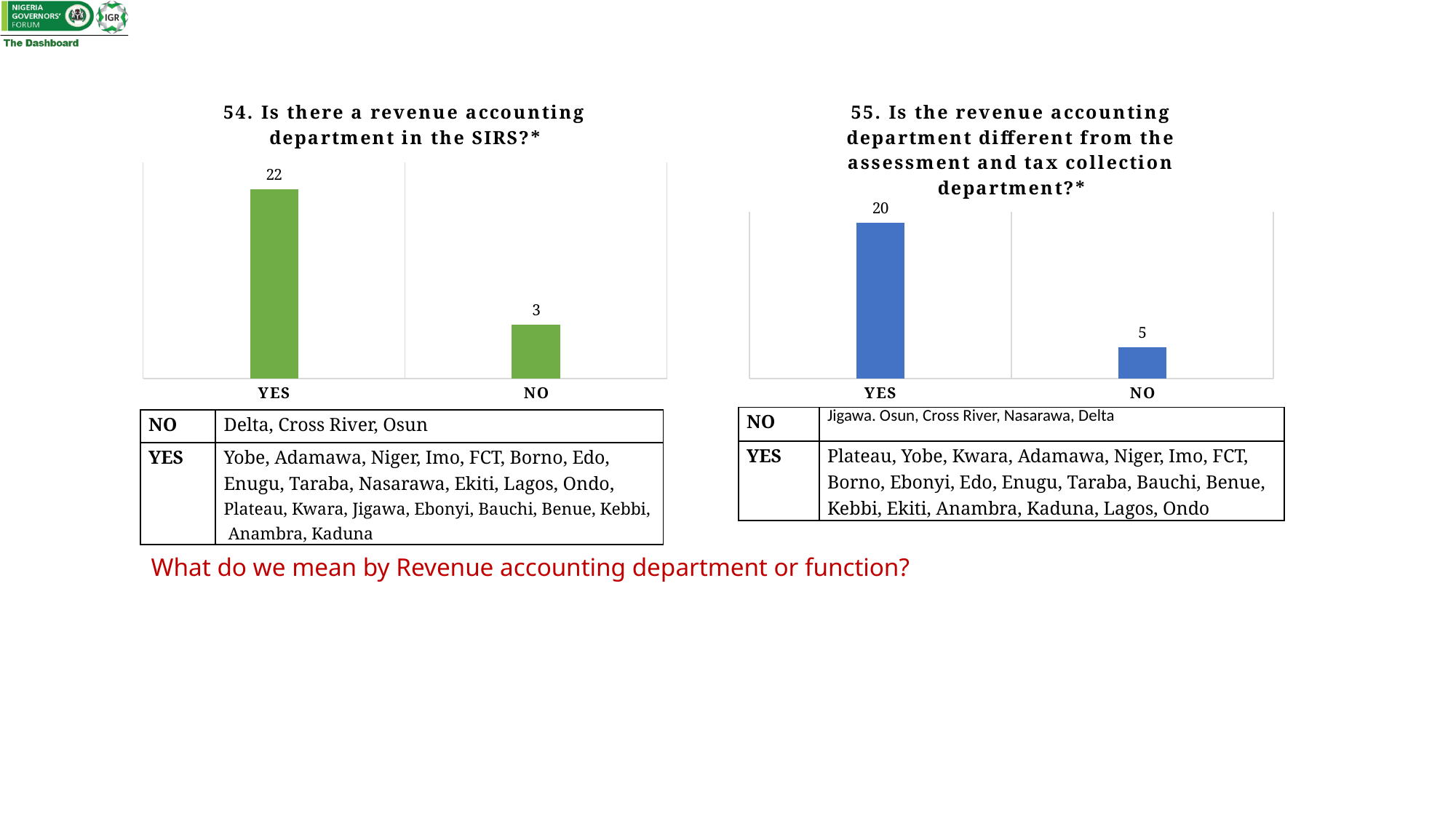
In the left chart (question 54), which category has the highest value? YES In the right chart (question 55), what is the value for YES? 20 In the right chart (question 55), what is the difference between the YES and NO values? 15 In the right chart (question 55), which category has the lowest value? NO What type of chart is the right chart (question 55)? Bar chart In the left chart (question 54), what is the value for YES? 22 In the left chart (question 54), what is the value for NO? 3 In the left chart (question 54), what is the difference between the YES and NO values? 19 Which is larger: the YES value in the left chart (question 54) or the YES value in the right chart (question 55)? The left chart (question 54), 22 How many categories are shown in the left chart (question 54)? 2 What colour are the bars in the left chart (question 54)? Green In the right chart (question 55), what is the value for NO? 5